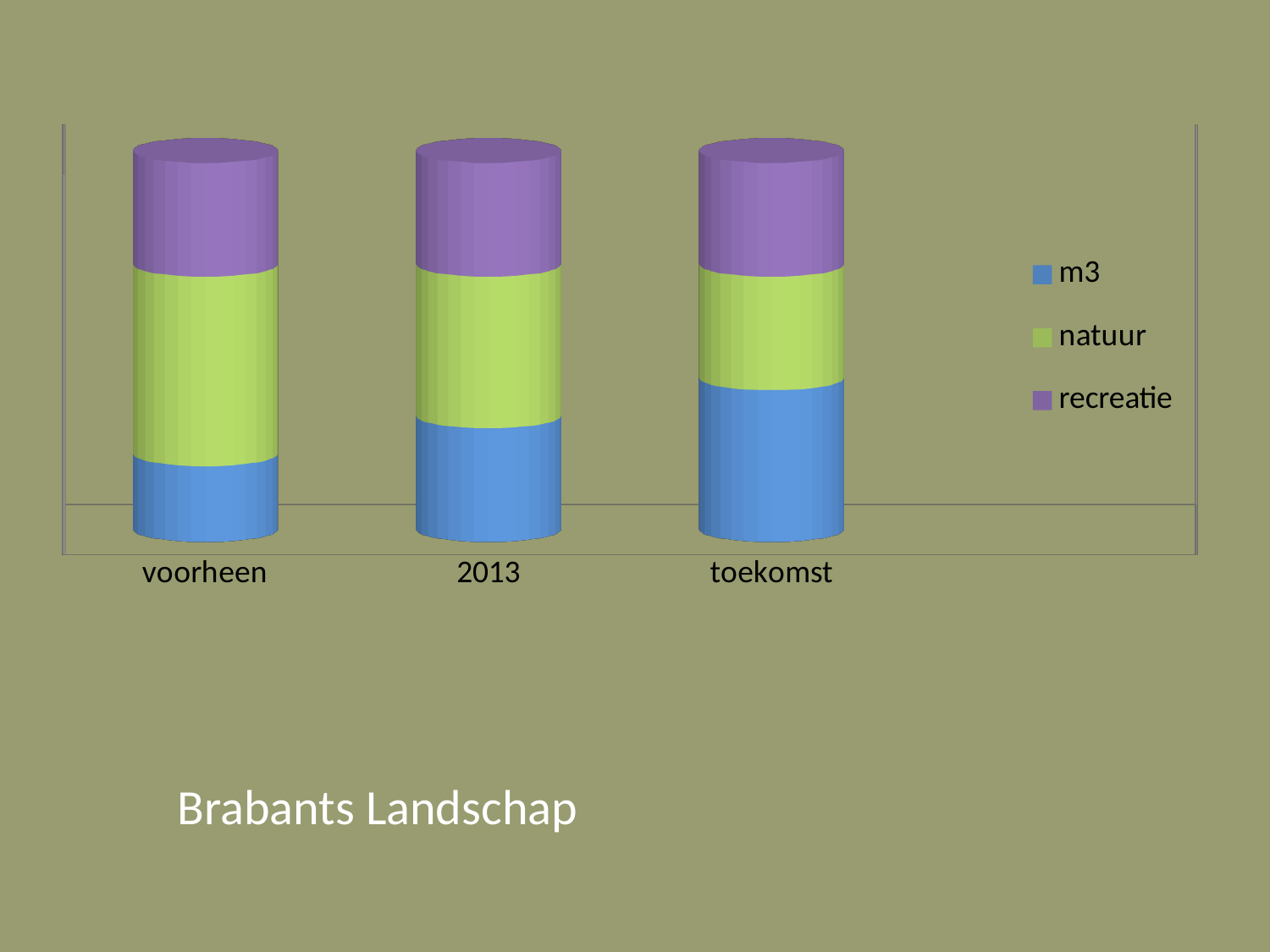
Which category has the largest 'm3' segment? toekomst What kind of chart is shown on the slide? Stacked bar chart Which colour represents the 'natuur' series in the chart? Green Which category has the smallest 'natuur' segment? toekomst What are the three series listed in the chart's legend? m3, natuur, recreatie Which category has the smallest 'm3' segment? voorheen How many series does the chart's legend list? 3 In the 'voorheen' bar, which segment is larger: 'm3' or 'natuur'? natuur Does the 'm3' segment rise or fall from 'voorheen' to 'toekomst'? Rise Does the 'natuur' segment rise or fall from 'voorheen' to 'toekomst'? Fall Which category has the largest 'natuur' segment? voorheen How many categories are shown along the x axis of the chart? 3